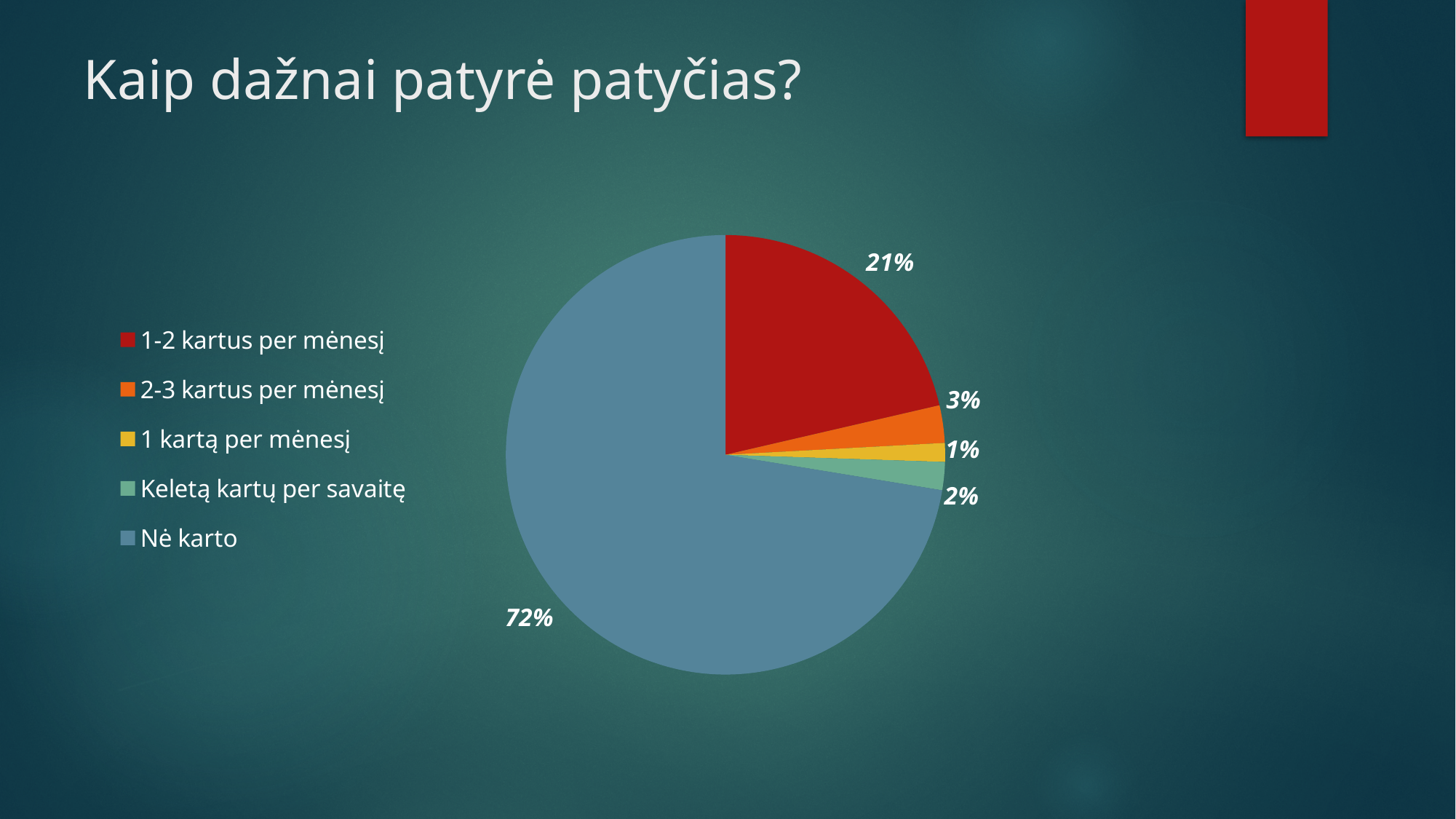
What is the difference between the shares for "Nė karto" and "1-2 kartus per mėnesį"? 51% What kind of chart is shown on the slide? Pie chart Which is larger, the share for "2-3 kartus per mėnesį" or for "Keletą kartų per savaitę"? 2-3 kartus per mėnesį What share of the pie does "1-2 kartus per mėnesį" take? 21% What is the value for "1 kartą per mėnesį"? 1% What is the title of the slide containing the chart? Kaip dažnai patyrė patyčias? What is the value for "Keletą kartų per savaitę"? 2% Which category has the smallest slice of the pie? 1 kartą per mėnesį What is the value for "2-3 kartus per mėnesį"? 3% How many categories does the pie chart show? 5 Which category has the largest slice of the pie? Nė karto What share of the pie does "Nė karto" take? 72%